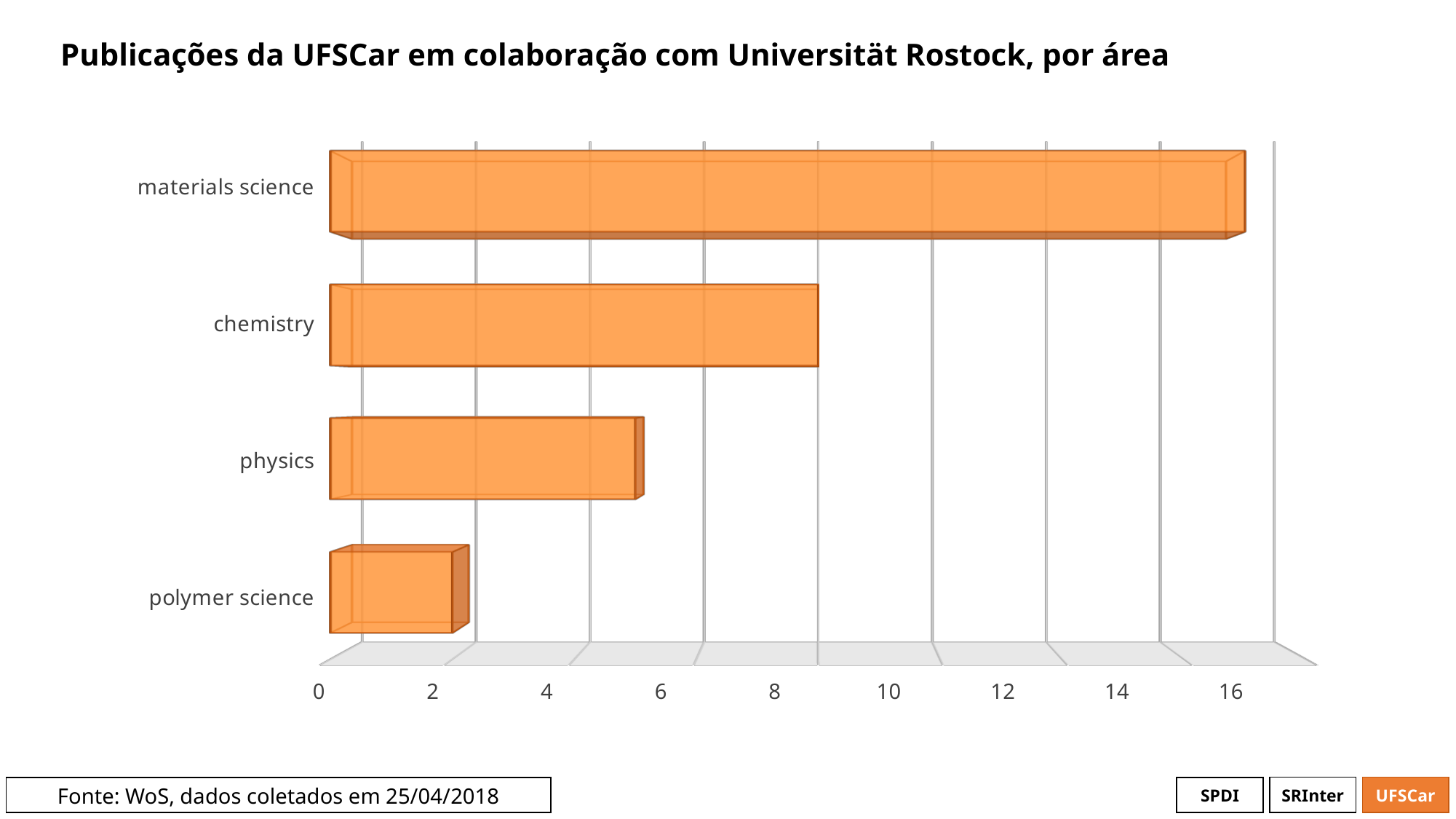
Which has more publications, chemistry or physics? chemistry Is the value for polymer science greater or less than 4? less What is the title of the chart? Publicações da UFSCar em colaboração com Universität Rostock, por área How many areas (categories) are shown in the chart? 4 Is the value for physics greater or less than 6? less Is the value for chemistry greater or less than 6? greater Which area has the lowest number of publications? polymer science Which area has the highest number of publications? materials science What kind of chart is shown on the slide? bar chart What is the data source stated on the slide? WoS, dados coletados em 25/04/2018